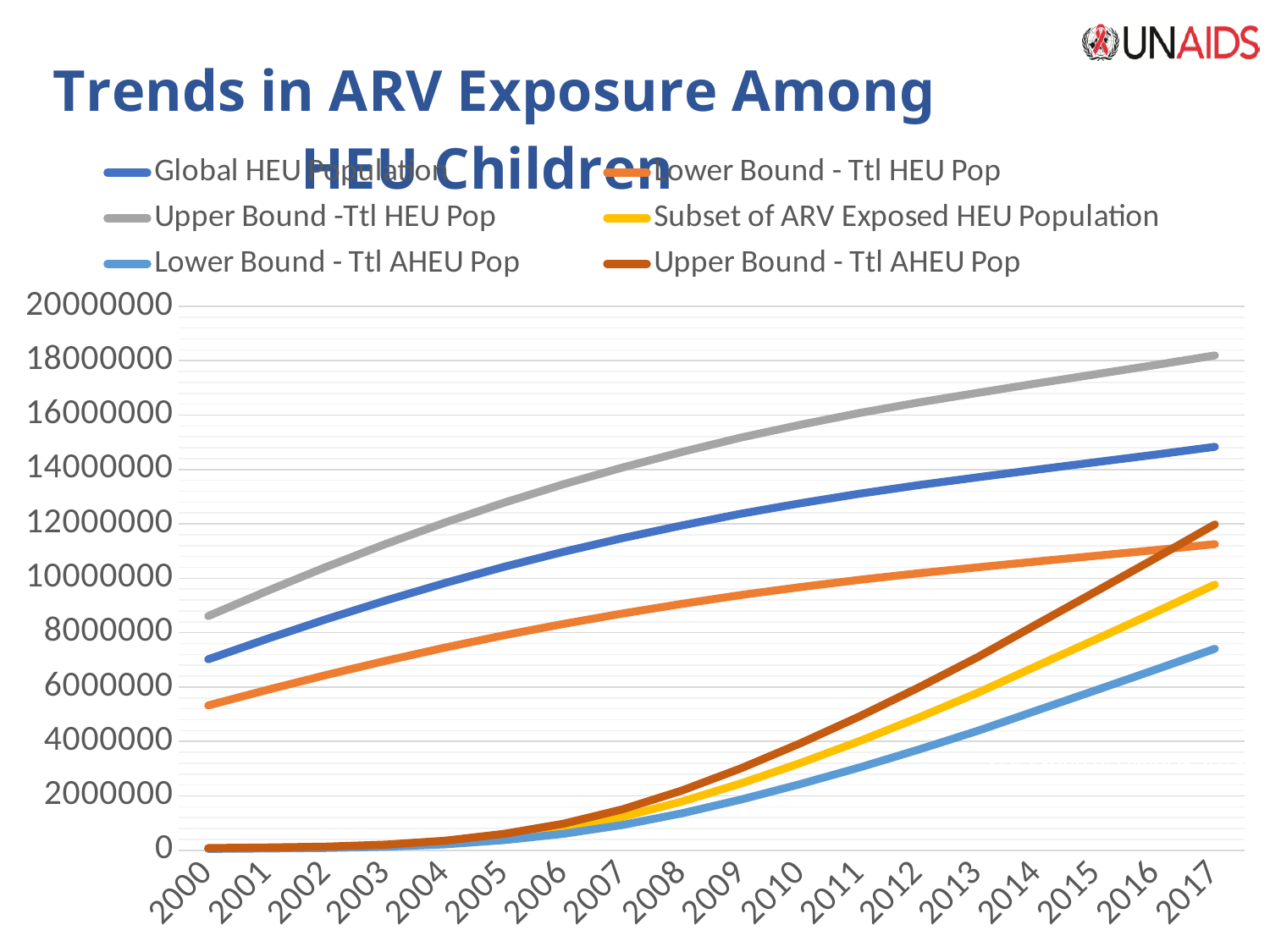
Is the value for Global HEU Population in 2000 greater or less than 8000000? less What kind of chart is shown on the slide? line chart In 2017, which is larger: Global HEU Population or Subset of ARV Exposed HEU Population? Global HEU Population How many series does the legend list? 6 Which series has the lowest value in 2017? Lower Bound - Ttl AHEU Pop Which series is drawn in grey? Upper Bound -Ttl HEU Pop Which series has the highest value in 2017? Upper Bound -Ttl HEU Pop How many years are shown along the x axis? 18 Is the value for Upper Bound -Ttl HEU Pop in 2017 greater or less than 16000000? greater What is the title of the slide's chart? Trends in ARV Exposure Among HEU Children Does the Global HEU Population series rise or fall from 2000 to 2017? rise